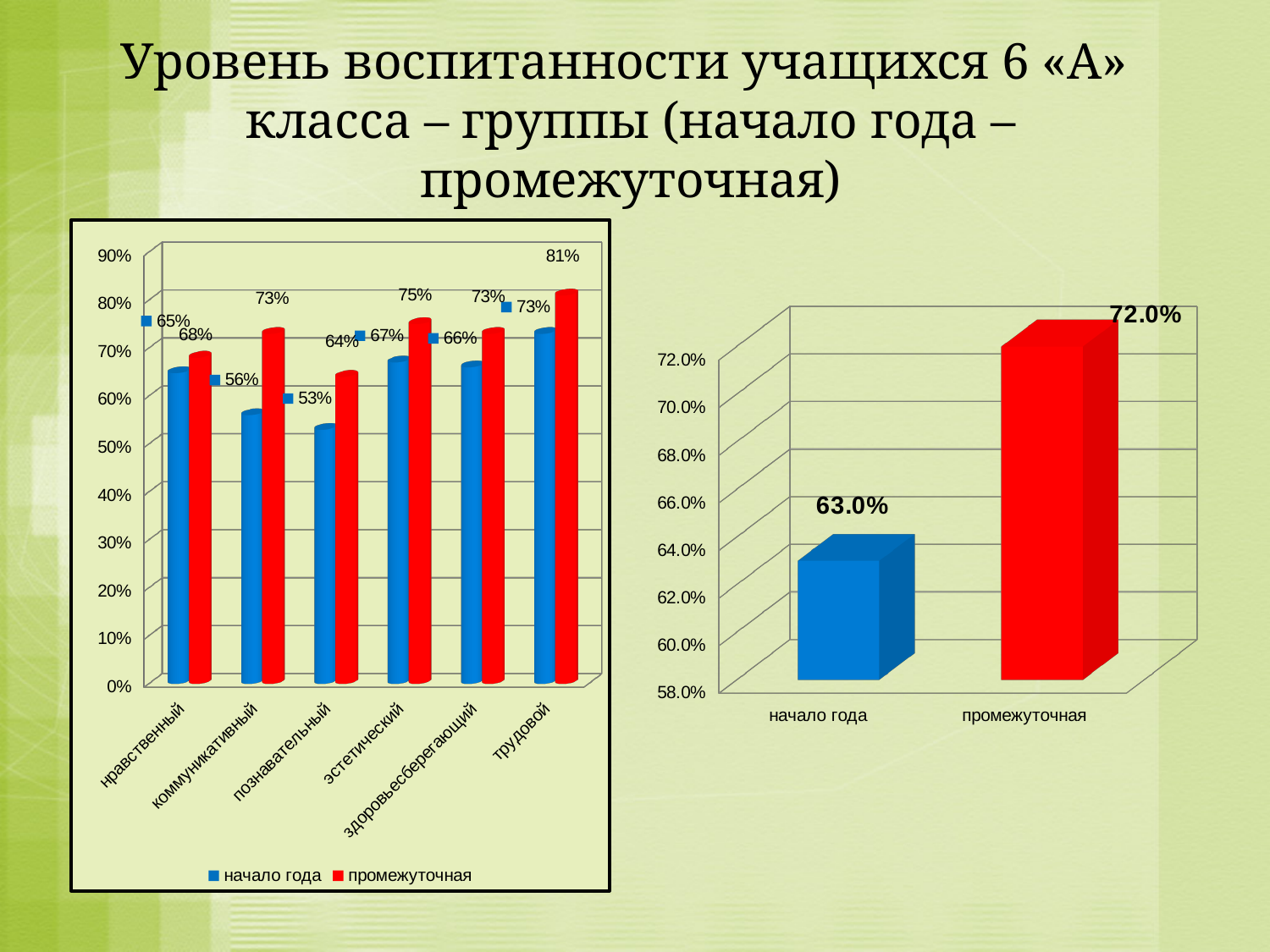
What kind of chart is the right chart? bar chart On the right chart, what is the difference between промежуточная and начало года? 9.0% On the left chart, what is the difference between промежуточная and начало года in the category коммуникативный? 17% How many series does the legend of the left chart list? 2 On the left chart, which category has the lowest value for начало года? познавательный On the left chart, what is the value for начало года in the category трудовой? 73% On the left chart, what is the value for начало года in the category коммуникативный? 56% On the left chart, which category has the highest value for промежуточная? трудовой How many categories are shown on the left chart? 6 On the left chart, which is larger in the category эстетический: начало года or промежуточная? промежуточная On the right chart, what is the value for промежуточная? 72.0% On the left chart, what is the value for промежуточная in the category познавательный? 64%